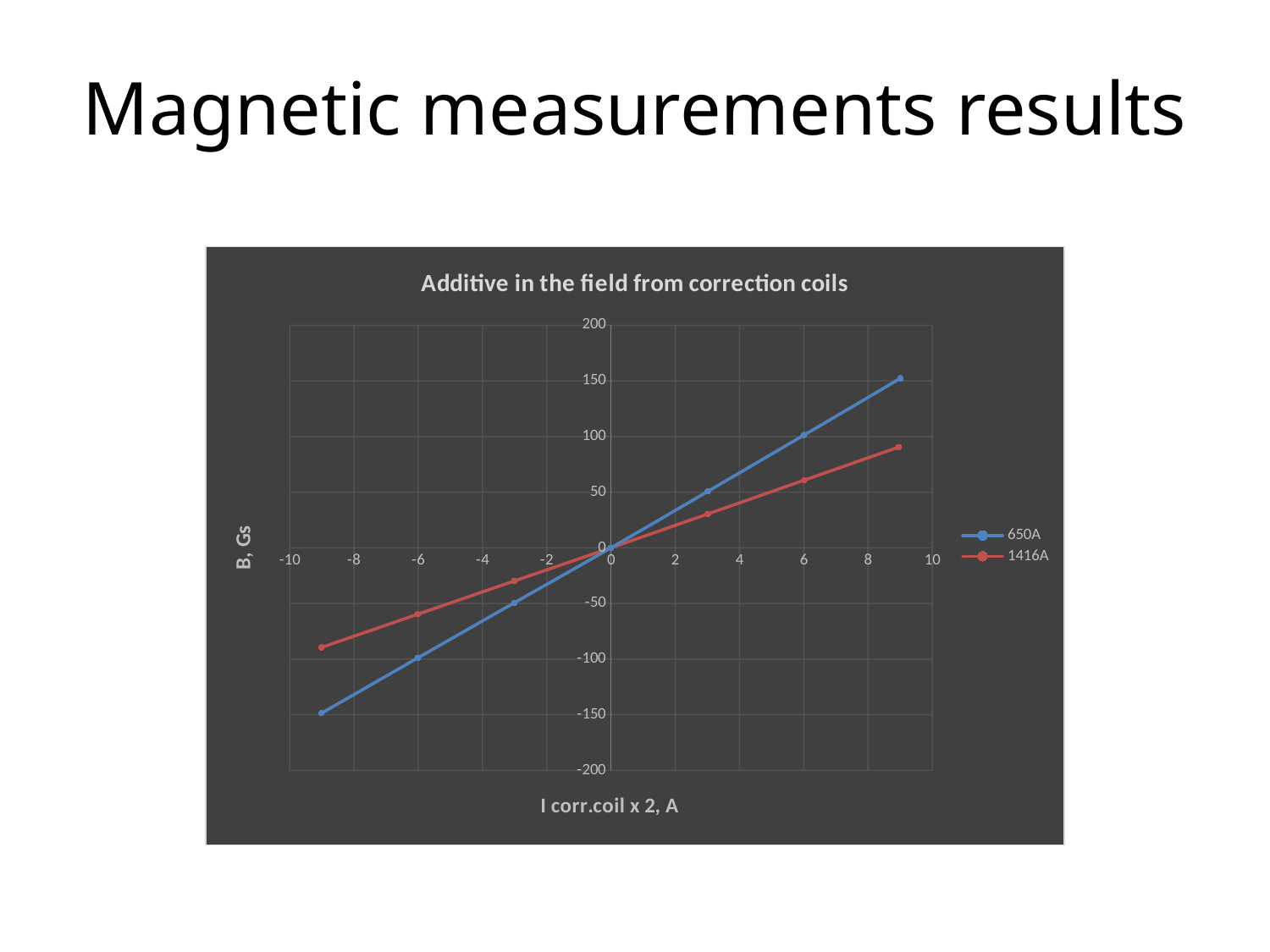
How many data points are plotted for the 650A series? 7 Do the values of the 1416A series rise or fall as the x-axis value increases? rise Is the value of the 650A series at x = 9 greater or less than 100? greater At x = -9, which series has the lower value, 650A or 1416A? 650A What is the label of the y-axis? B, Gs Is the value of the 1416A series at x = -9 greater or less than -100? greater How many series does the legend list? 2 Is the value of the 1416A series at x = 9 greater or less than 100? less What is the title of the chart? Additive in the field from correction coils What kind of chart is shown on the slide? line chart Do the values of the 650A series rise or fall as the x-axis value increases? rise At x = 9, which series has the larger value, 650A or 1416A? 650A